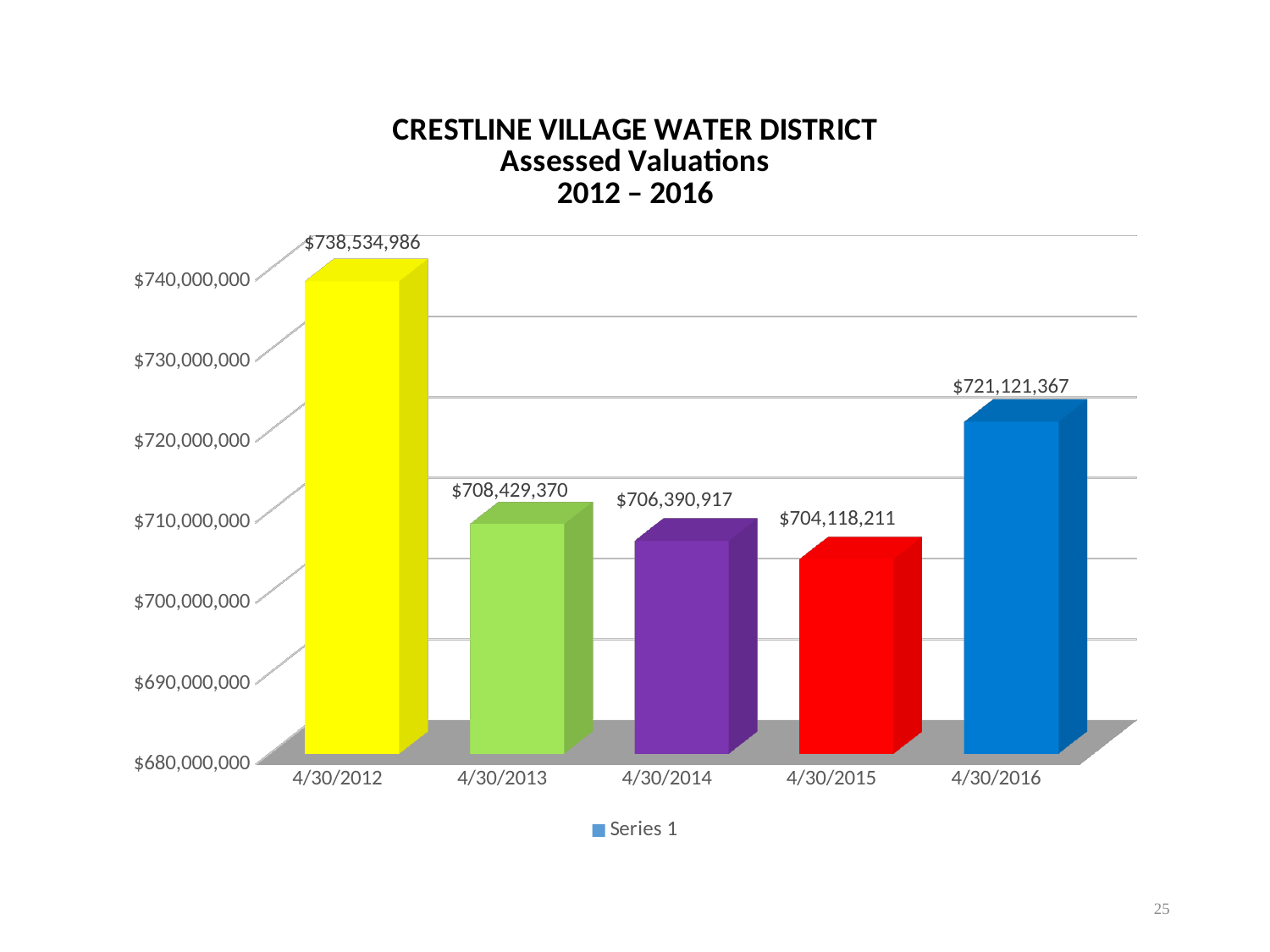
How many dates are shown on the x axis? 5 What is the assessed valuation for 4/30/2012? $738,534,986 Is the assessed valuation for 4/30/2015 greater or less than $710,000,000? less What is the difference between the assessed valuations for 4/30/2013 and 4/30/2015? $4,311,159 What is the assessed valuation for 4/30/2016? $721,121,367 Which date has the lowest assessed valuation? 4/30/2015 Which is larger, the assessed valuation for 4/30/2013 or for 4/30/2016? 4/30/2016 What is the difference between the assessed valuations for 4/30/2012 and 4/30/2016? $17,413,619 Which date has the highest assessed valuation? 4/30/2012 Do the assessed valuations rise or fall from 4/30/2012 to 4/30/2015? fall What kind of chart is shown on the slide? bar chart What is the assessed valuation for 4/30/2014? $706,390,917